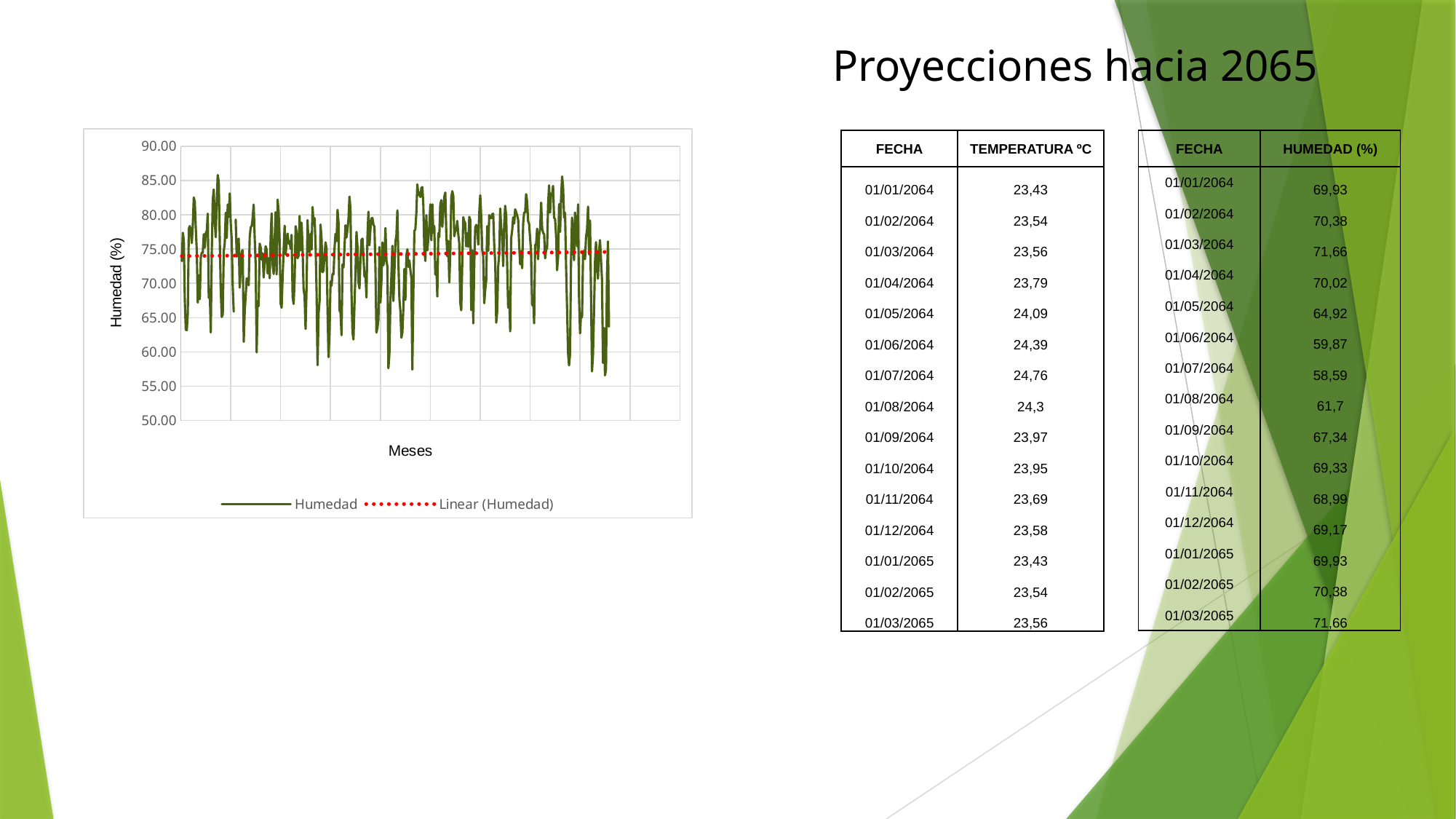
Is the lowest value of the Humedad series greater or less than 60.00? less Does the Humedad series ever rise above 90.00 on the chart? No Is the Linear (Humedad) trendline greater or less than 80.00? less What kind of chart is shown on the left of the slide? line chart What is the title of the horizontal axis of the chart? Meses What is the title of the vertical axis of the chart? Humedad (%) How many entries does the legend of the chart list? 2